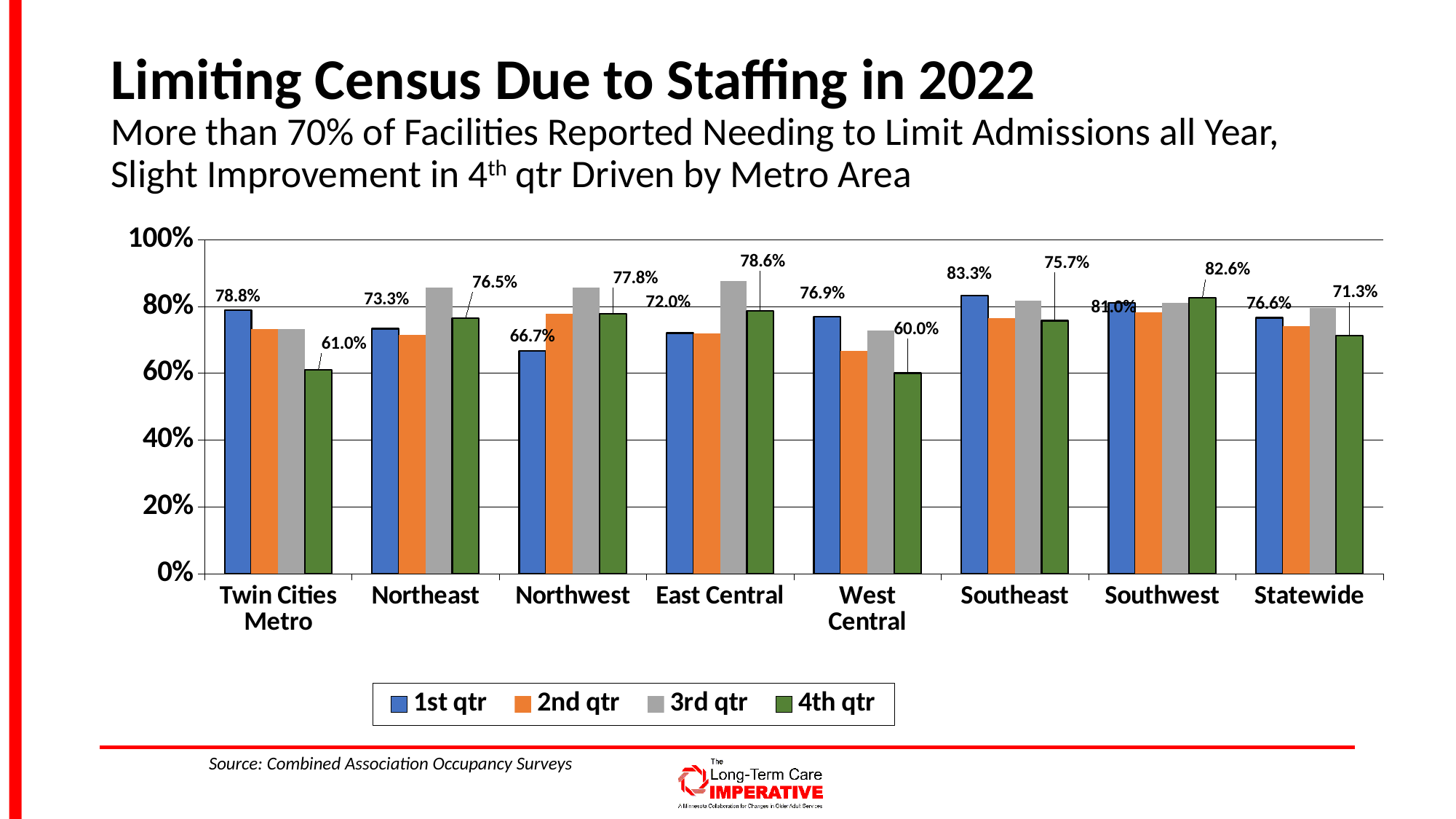
Is the 3rd qtr value for Northeast greater or less than 80%? greater What is the 4th qtr value for West Central? 60.0% Which region has the lowest 4th qtr value? West Central How many series does the legend list? 4 What is the difference between the 1st qtr and 4th qtr values for Twin Cities Metro? 17.8 percentage points How many regions are shown on the x axis? 8 Which region has the lowest 1st qtr value? Northwest Is the 2nd qtr value for West Central greater or less than 70%? less Which is larger for Northwest: the 1st qtr value or the 4th qtr value? 4th qtr Which region has the highest 1st qtr value? Southeast What is the 1st qtr value for Twin Cities Metro? 78.8% What is the 4th qtr value for Statewide? 71.3%